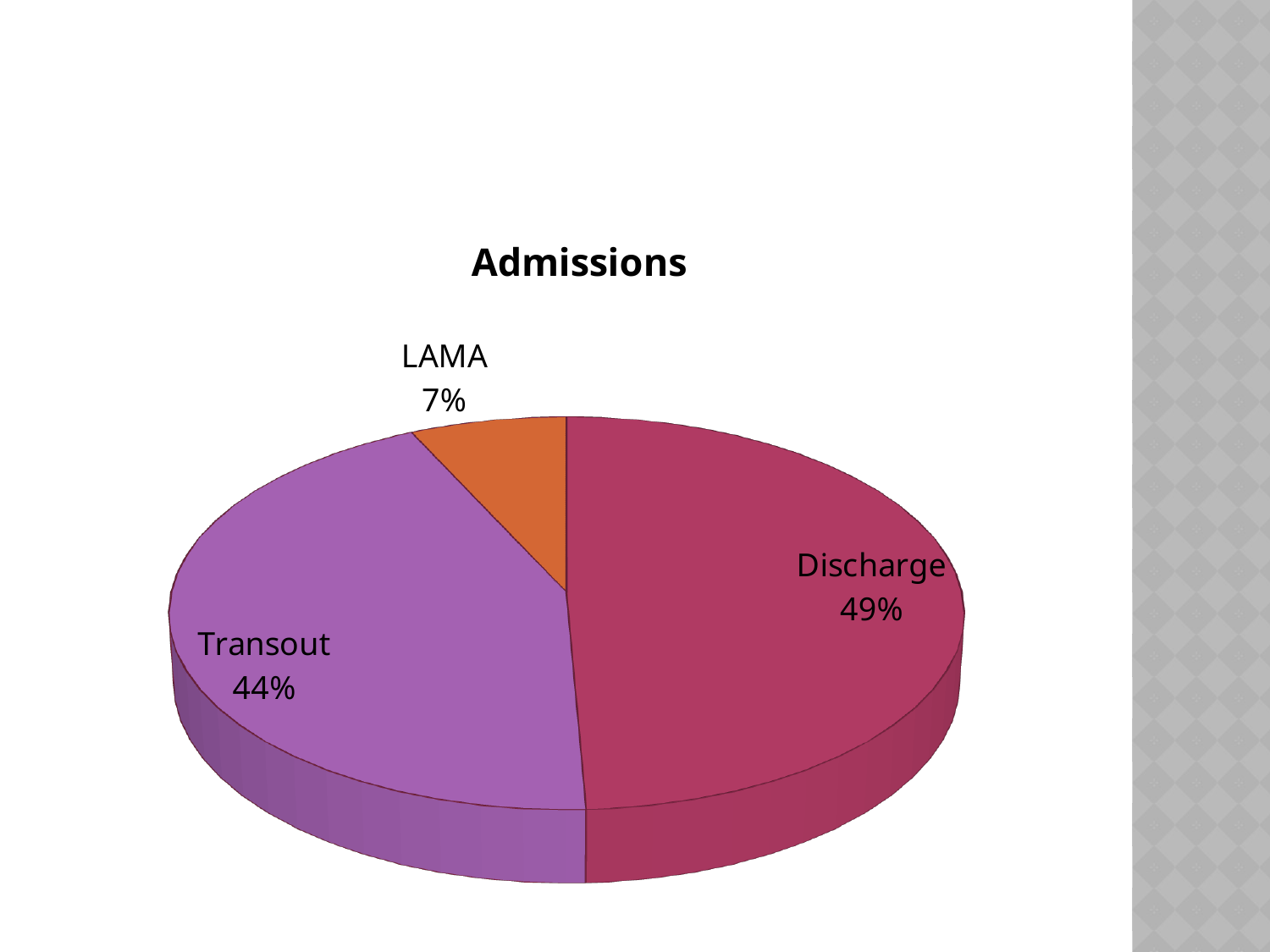
What share of admissions is Transout? 44% What share of admissions is Discharge? 49% What is the title of the chart? Admissions What type of chart is shown on the slide? pie chart Which category has the smallest share of the pie? LAMA Which is larger, the share for Transout or the share for LAMA? Transout What is the difference in percentage points between Transout and LAMA? 37 What is the difference in percentage points between Discharge and Transout? 5 What share of admissions is LAMA? 7% What colour is the LAMA slice? orange How many slices does the pie chart have? 3 Which category has the largest share of the pie? Discharge